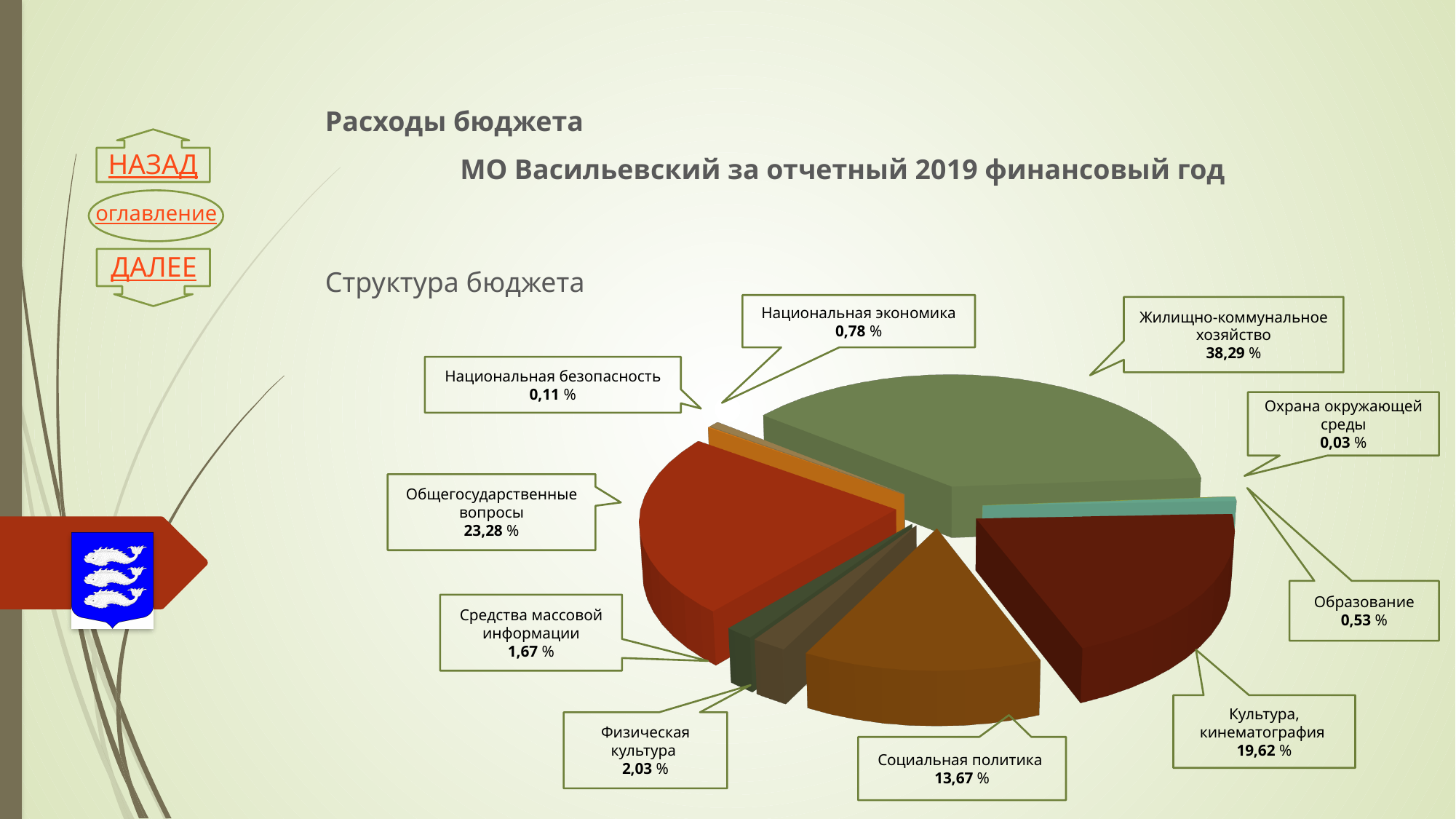
What share of budget expenditure goes to Социальная политика? 13,67 % Which is larger: the share for Общегосударственные вопросы or for Культура, кинематография? Общегосударственные вопросы Which category has the smallest share of the budget? Охрана окружающей среды What share of budget expenditure goes to Физическая культура? 2,03 % What share of budget expenditure goes to Культура, кинематография? 19,62 % What is the difference between the shares for Жилищно-коммунальное хозяйство and Общегосударственные вопросы? 15,01 % Which category has the largest share of the budget? Жилищно-коммунальное хозяйство What is the difference between the shares for Средства массовой информации and Национальная экономика? 0,89 % How many categories are shown in the pie chart? 10 What share of budget expenditure goes to Жилищно-коммунальное хозяйство? 38,29 % What kind of chart is shown on the slide? pie chart What is the title of the chart section on the slide? Структура бюджета